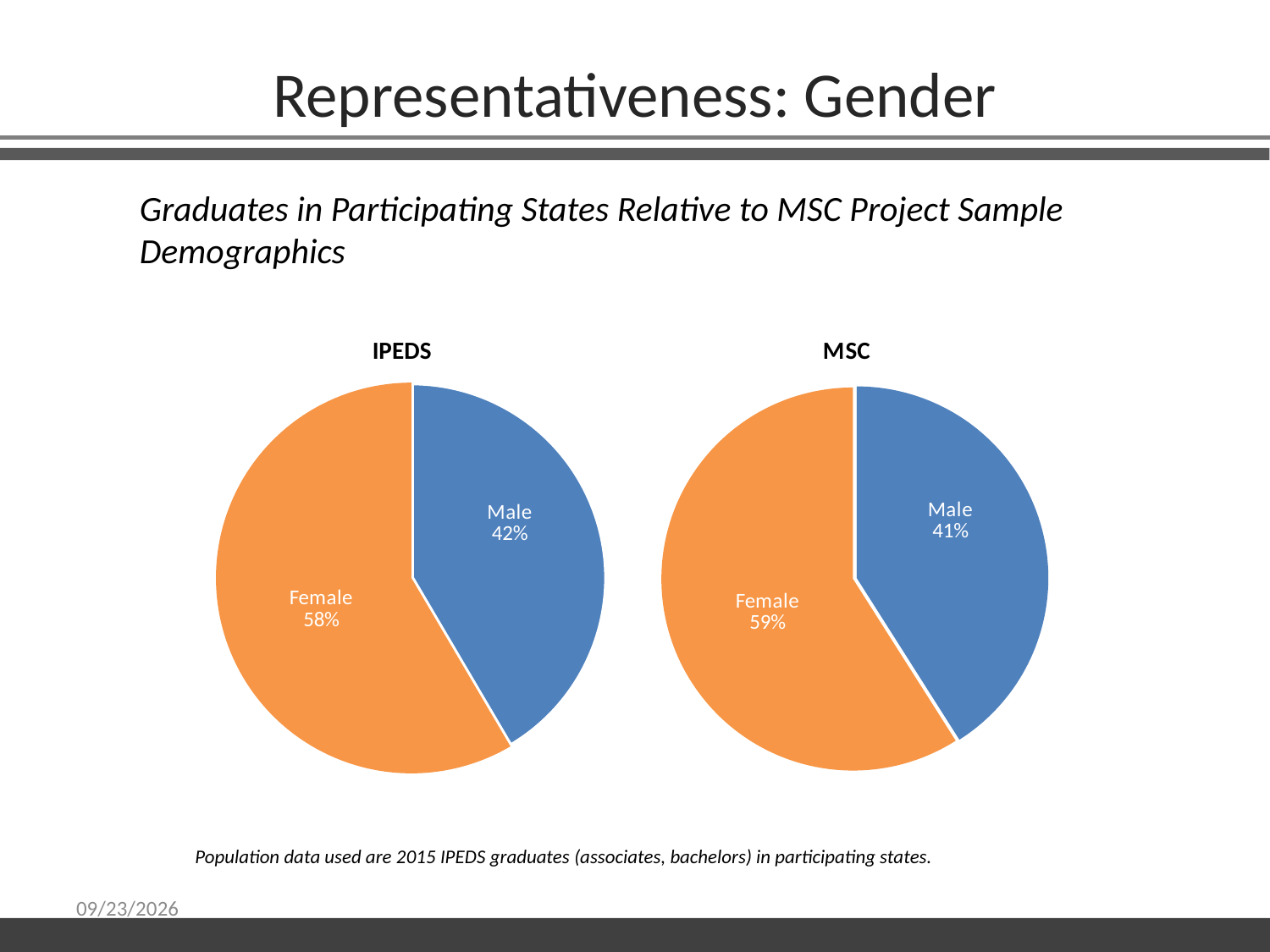
In the IPEDS pie chart, what share is Female? 58% In the MSC pie chart, what share is Male? 41% What colour is the Female slice in the MSC pie chart? Orange What type of chart is the IPEDS chart? Pie chart In the MSC pie chart, what share is Female? 59% How many slices does the MSC pie chart have? 2 In the IPEDS pie chart, what share is Male? 42% In the MSC pie chart, which slice is the smallest? Male In the IPEDS pie chart, which slice is the largest? Female In the IPEDS pie chart, what is the difference between the Female and Male shares? 16% In the MSC pie chart, what is the difference between the Female and Male shares? 18% Is the Male share larger in the IPEDS chart or the MSC chart? IPEDS